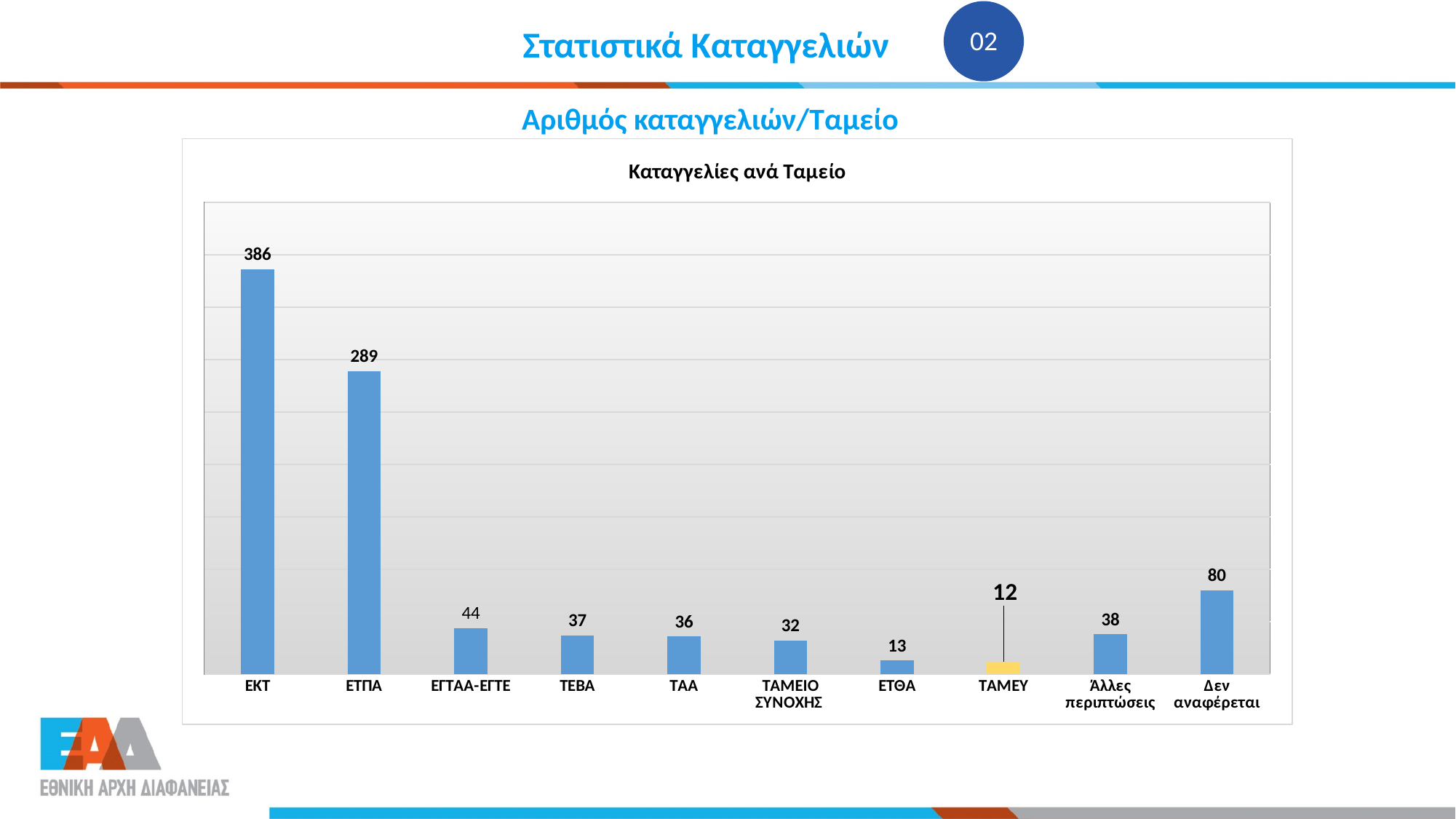
What is the value for ΤΑΜΕΥ? 12 Which category has the lowest value? ΤΑΜΕΥ What is the value for ΕΤΠΑ? 289 What is the title of the chart? Καταγγελίες ανά Ταμείο What is the difference between the values for ΕΚΤ and ΕΤΠΑ? 97 What is the value for ΕΚΤ in the chart? 386 What is the value for Δεν αναφέρεται? 80 Which category has the highest value? ΕΚΤ What kind of chart is shown on the slide? bar chart Which bar is coloured differently (yellow) from the others? ΤΑΜΕΥ How many categories are shown on the x axis? 10